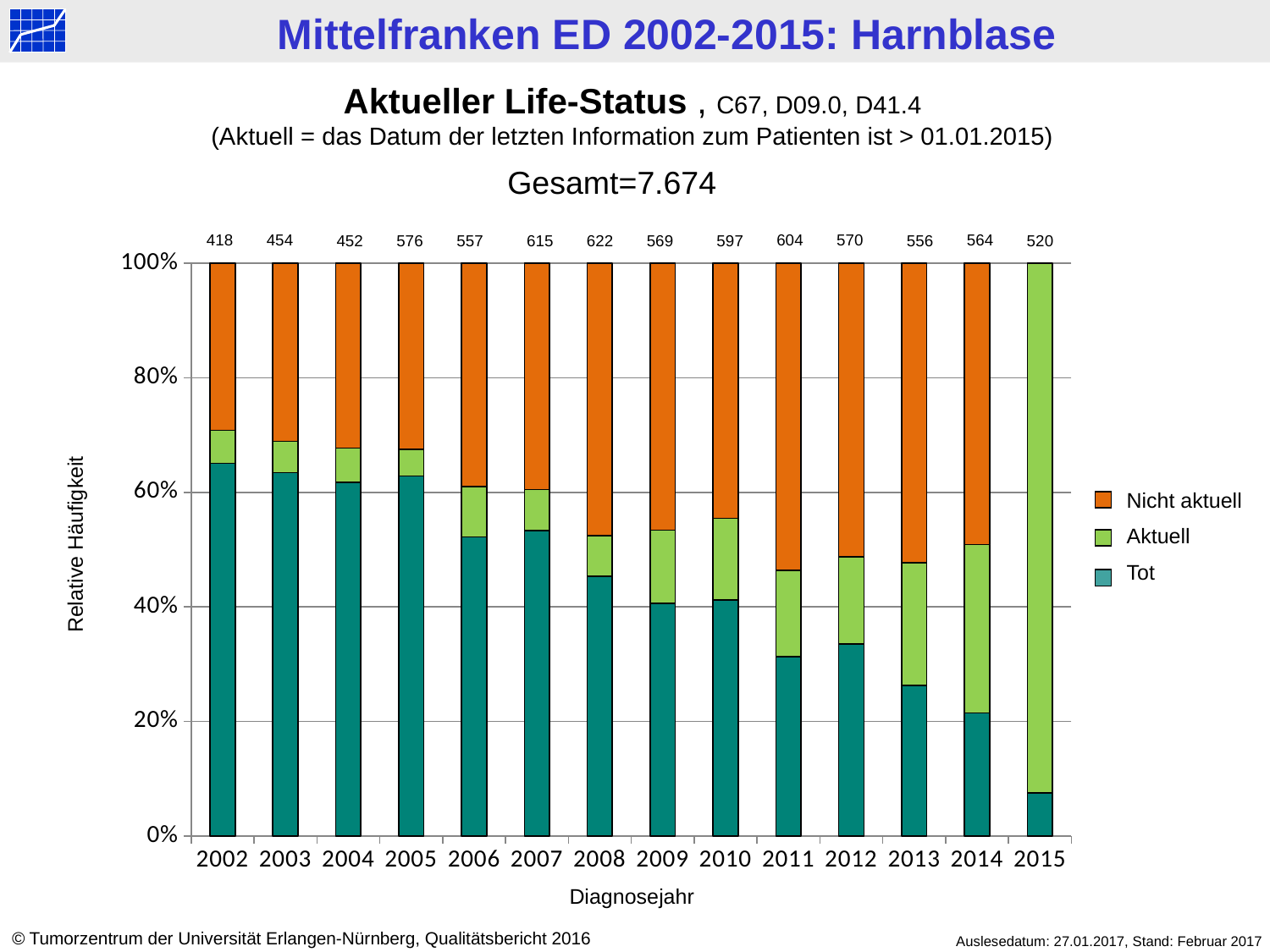
What kind of chart is shown on the slide? Stacked bar chart Which year has the lowest number printed above its bar? 2002 What is the difference between the numbers printed above the bars for 2008 and 2002? 204 What number is printed above the bar for 2015? 520 How many series does the legend list? 3 How many diagnosis years are shown on the x axis? 14 What number is printed above the bar for 2002? 418 Is the Tot share for 2002 greater or less than 60%? greater Which year has the highest number printed above its bar? 2008 Is the Tot share for 2015 greater or less than 20%? less What number is printed above the bar for 2008? 622 Which year has the larger number printed above its bar, 2005 or 2006? 2005